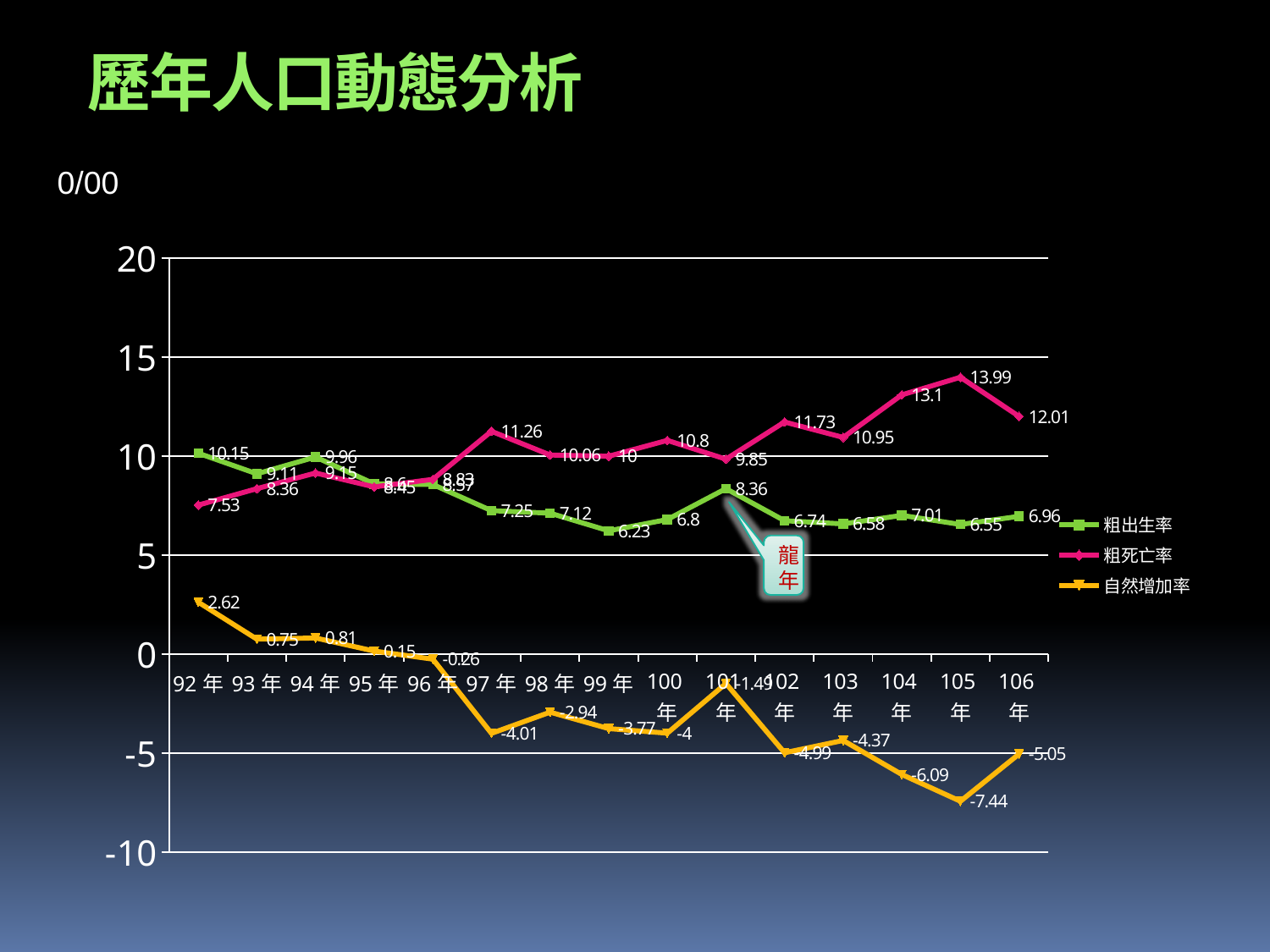
How many years (categories) are plotted along the x axis? 15 What type of chart is shown on the slide? line chart Does 粗死亡率 generally rise or fall from 92年 to 106年? rise Which is larger in 101年, 粗出生率 or 粗死亡率? 粗死亡率 In which year is 自然增加率 lowest? 105年 In which year is 粗死亡率 highest? 105年 What is the difference between 粗死亡率 and 粗出生率 in 104年? 6.09 What is the value of 粗死亡率 in 105年? 13.99 What is the value of 自然增加率 in 106年? -5.05 What is the value of 粗出生率 in 92年? 10.15 Which year is marked with the callout 龍年? 101年 How many series does the legend list? 3